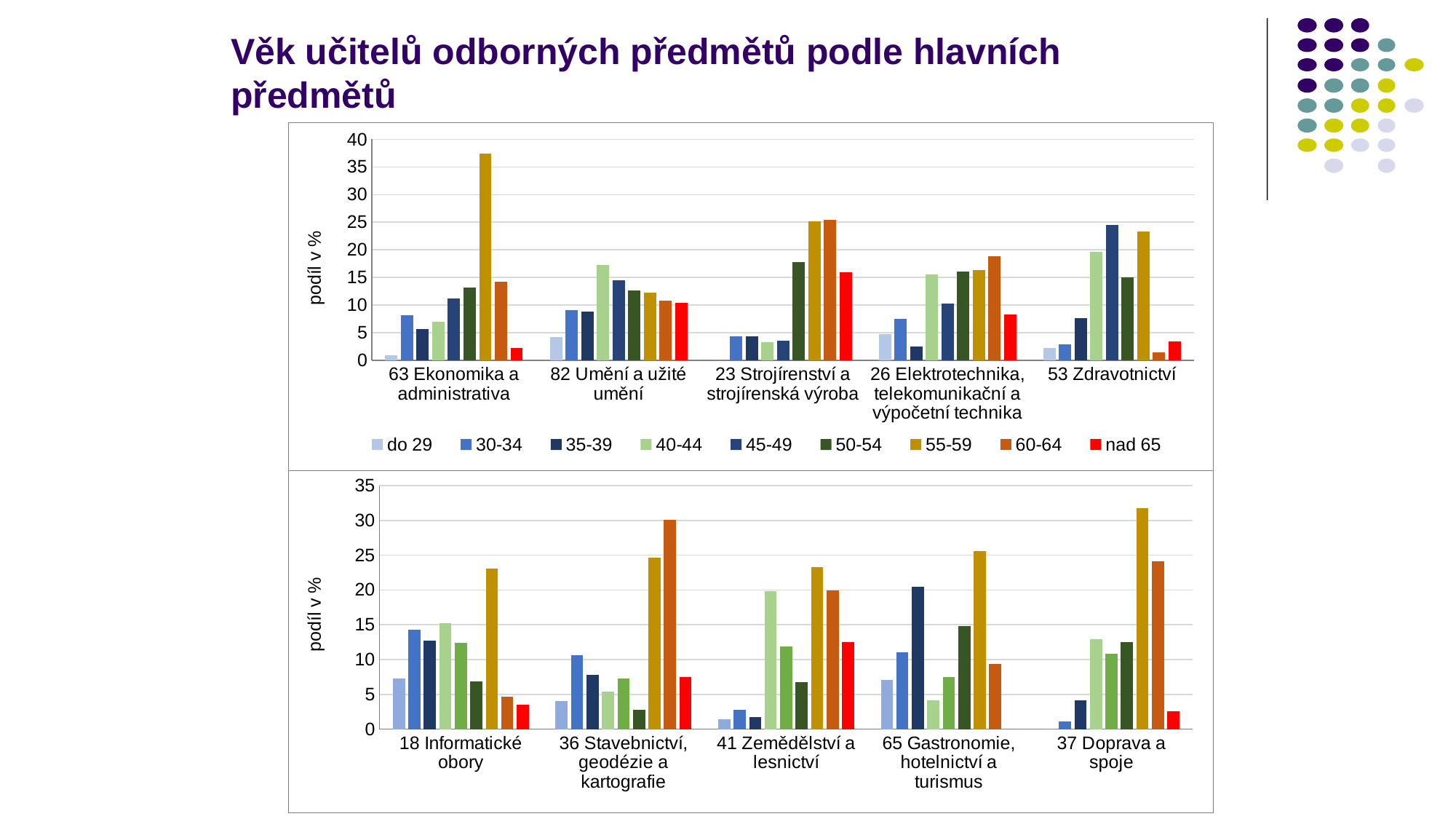
How many age groups does the legend list? 9 In the bottom chart, is the value for the do 29 group in 41 Zemědělství a lesnictví greater or less than 5? less In the top chart, which age group has the highest share for 63 Ekonomika a administrativa? 55-59 In the bottom chart, is the value for the 55-59 group in 37 Doprava a spoje greater or less than 30? greater What is the label of the y axis on the bottom chart? podíl v % How many categories are shown on the x axis of the top chart? 5 In the top chart, is the value for the 40-44 group in 23 Strojírenství a strojírenská výroba greater or less than 5? less In the bottom chart, which age group has the highest share for 36 Stavebnictví, geodézie a kartografie? 60-64 In the top chart, which is larger for 53 Zdravotnictví: the 45-49 group or the 60-64 group? 45-49 What kind of chart is the top chart? bar chart In the bottom chart, which is larger for 65 Gastronomie, hotelnictví a turismus: the 45-49 group or the 55-59 group? 55-59